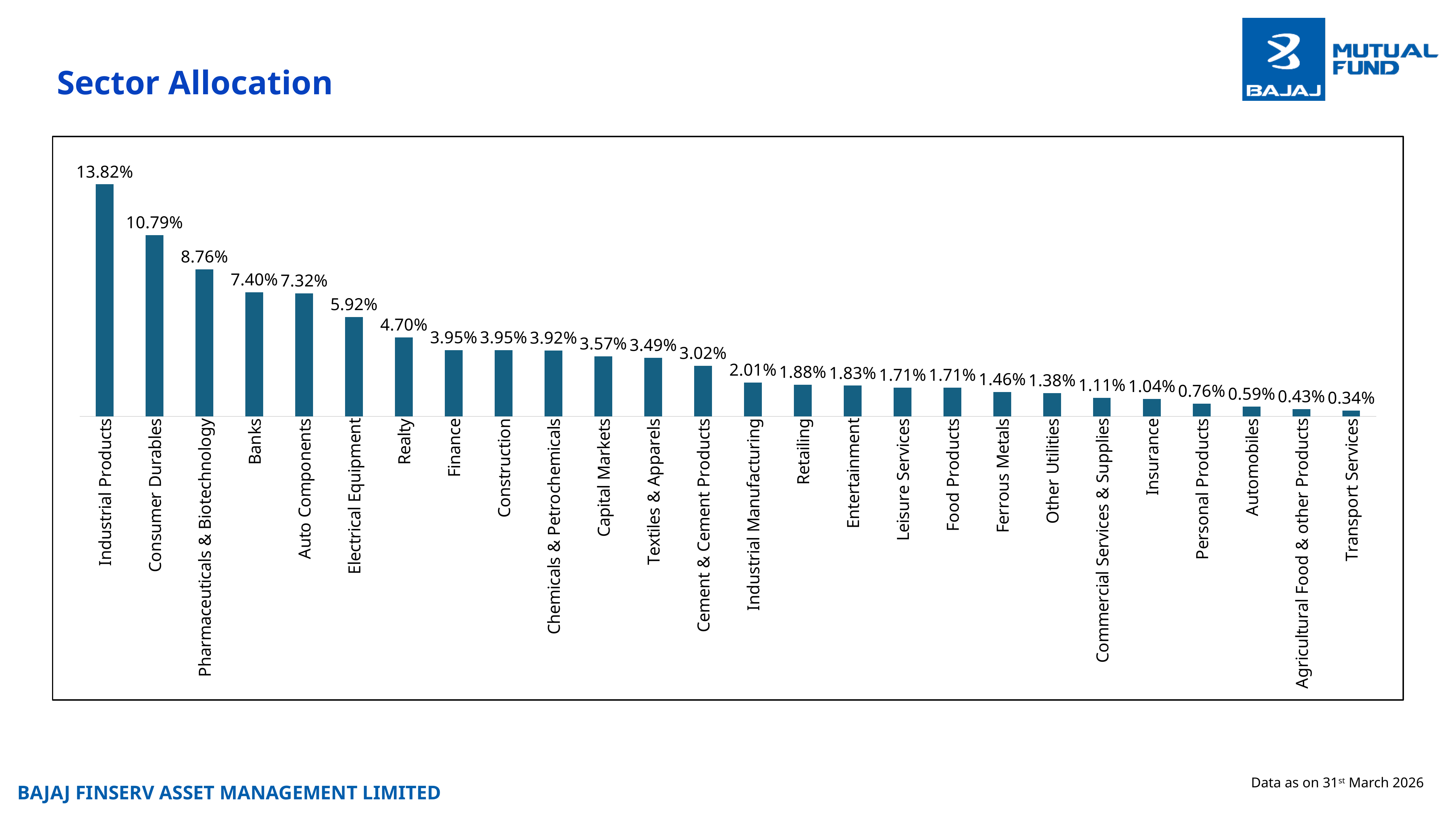
What kind of chart is shown on the slide? Bar chart What is the allocation for Banks? 7.40% Do the allocation values rise or fall from left to right across the chart? Fall What is the allocation for Industrial Products? 13.82% What is the difference between the allocations for Electrical Equipment and Realty? 1.22% Which has a larger allocation, Pharmaceuticals & Biotechnology or Auto Components? Pharmaceuticals & Biotechnology Which sector has the highest allocation? Industrial Products What is the allocation for Cement & Cement Products? 3.02% What is the allocation for Insurance? 1.04% Which sector has the lowest allocation? Transport Services How many sectors are shown in the chart? 26 What is the difference between the allocations for Industrial Products and Consumer Durables? 3.03%